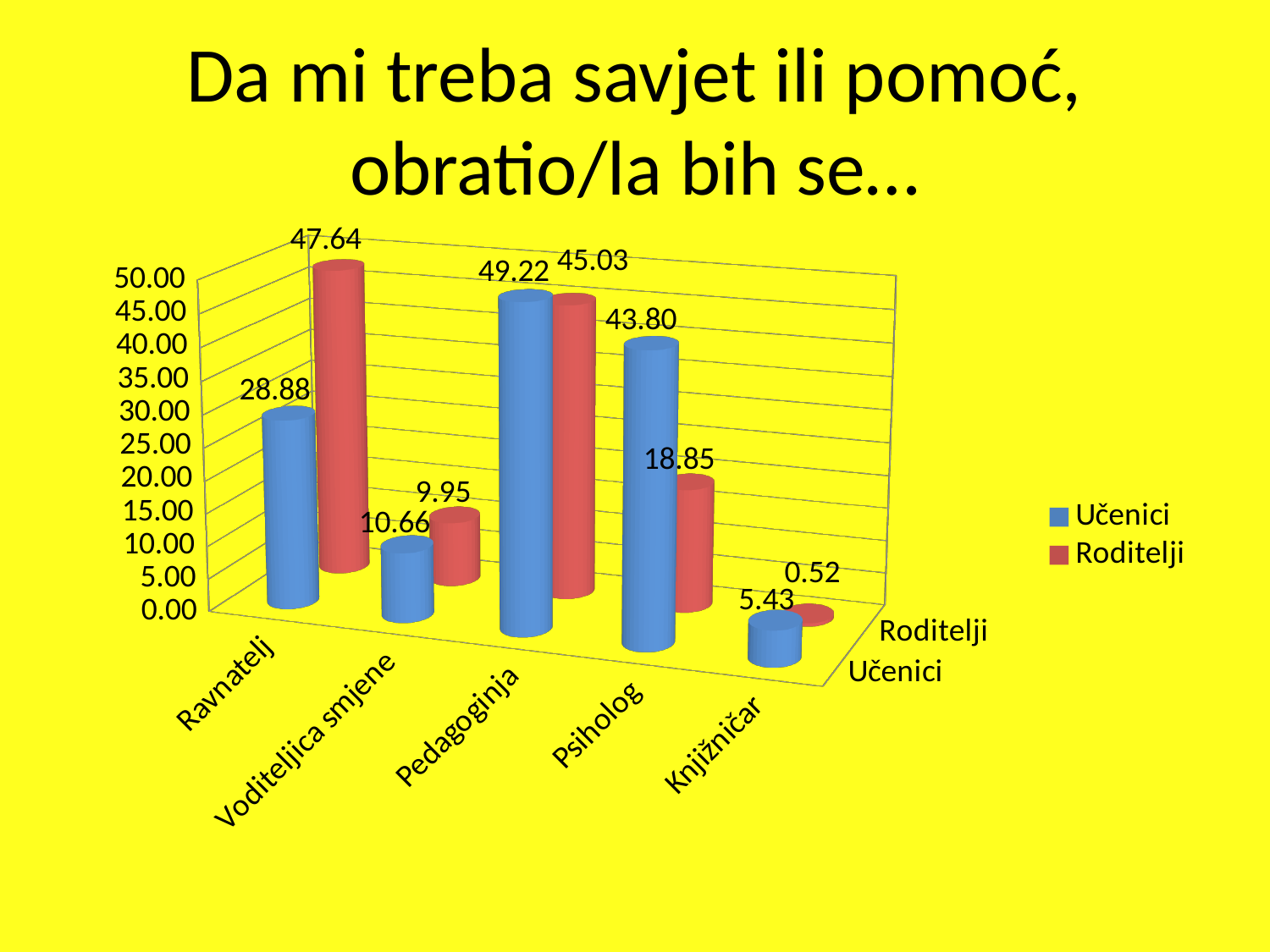
What is the value for Roditelji for Ravnatelj? 47.64 How many series does the legend list? 2 What is the difference between the Roditelji and Učenici values for Ravnatelj? 18.76 What kind of chart is shown on the slide? Bar chart What is the value for Učenici for Pedagoginja? 49.22 How many categories are shown on the x axis? 5 Which category has the highest value for Učenici? Pedagoginja Which category has the lowest value for Roditelji? Knjižničar What is the value for Učenici for Ravnatelj? 28.88 For Psiholog, which series has the larger value, Učenici or Roditelji? Učenici What is the value for Roditelji for Psiholog? 18.85 What is the value for Roditelji for Knjižničar? 0.52